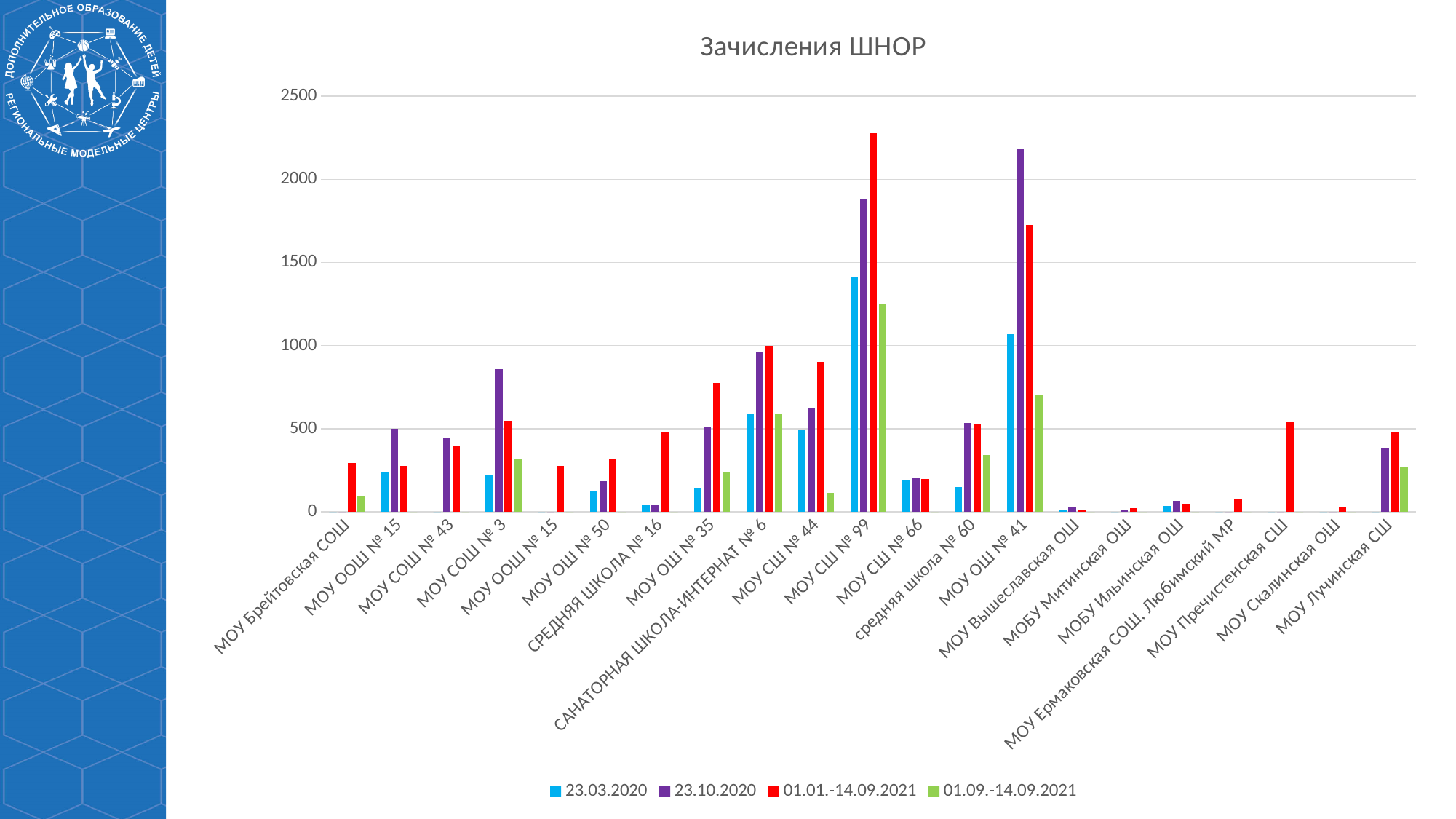
Is the 01.09.-14.09.2021 value for МОУ СШ № 99 greater or less than 1000? greater What kind of chart is shown on the slide? bar chart Is the 23.10.2020 value for МОУ СОШ № 3 greater or less than 500? greater Which school has the highest value for the 23.10.2020 series? МОУ ОШ № 41 Which school has the highest value for the 01.01.-14.09.2021 series? МОУ СШ № 99 Which series is shown in red in the legend? 01.01.-14.09.2021 Is the 01.01.-14.09.2021 value for МОУ СШ № 99 greater or less than 2000? greater Which school has the highest value for the 23.03.2020 series? МОУ СШ № 99 What is the title of the chart? Зачисления ШНОР How many series does the legend list? 4 How many school categories are shown on the x axis? 21 For the 01.01.-14.09.2021 series, which is larger: МОУ СШ № 99 or МОУ ОШ № 41? МОУ СШ № 99